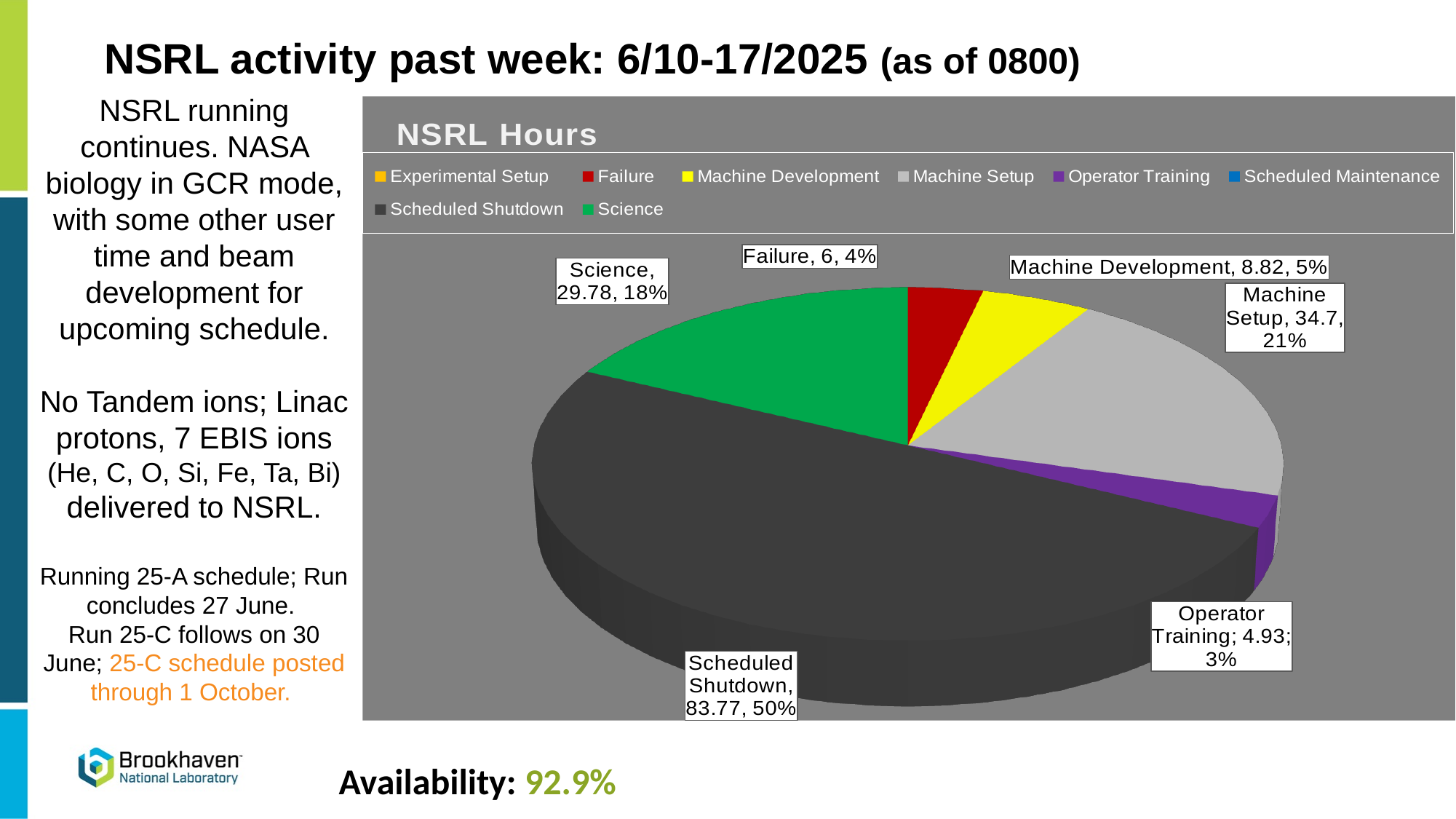
What kind of chart is shown on the slide? pie chart How many entries does the chart's legend list? 8 Which is larger, the hours for Machine Setup or the hours for Science? Machine Setup Which labelled category has the smallest slice of the pie? Operator Training Which labelled category has the largest slice of the pie? Scheduled Shutdown What is the difference in hours between Machine Development and Failure? 2.82 What is the title of the chart? NSRL Hours How many hours are labelled for Scheduled Shutdown? 83.77 What share of the pie does Operator Training represent? 3% What share of the pie does Failure represent? 4% How many hours are labelled for Science? 29.78 How many hours are labelled for Machine Setup? 34.7